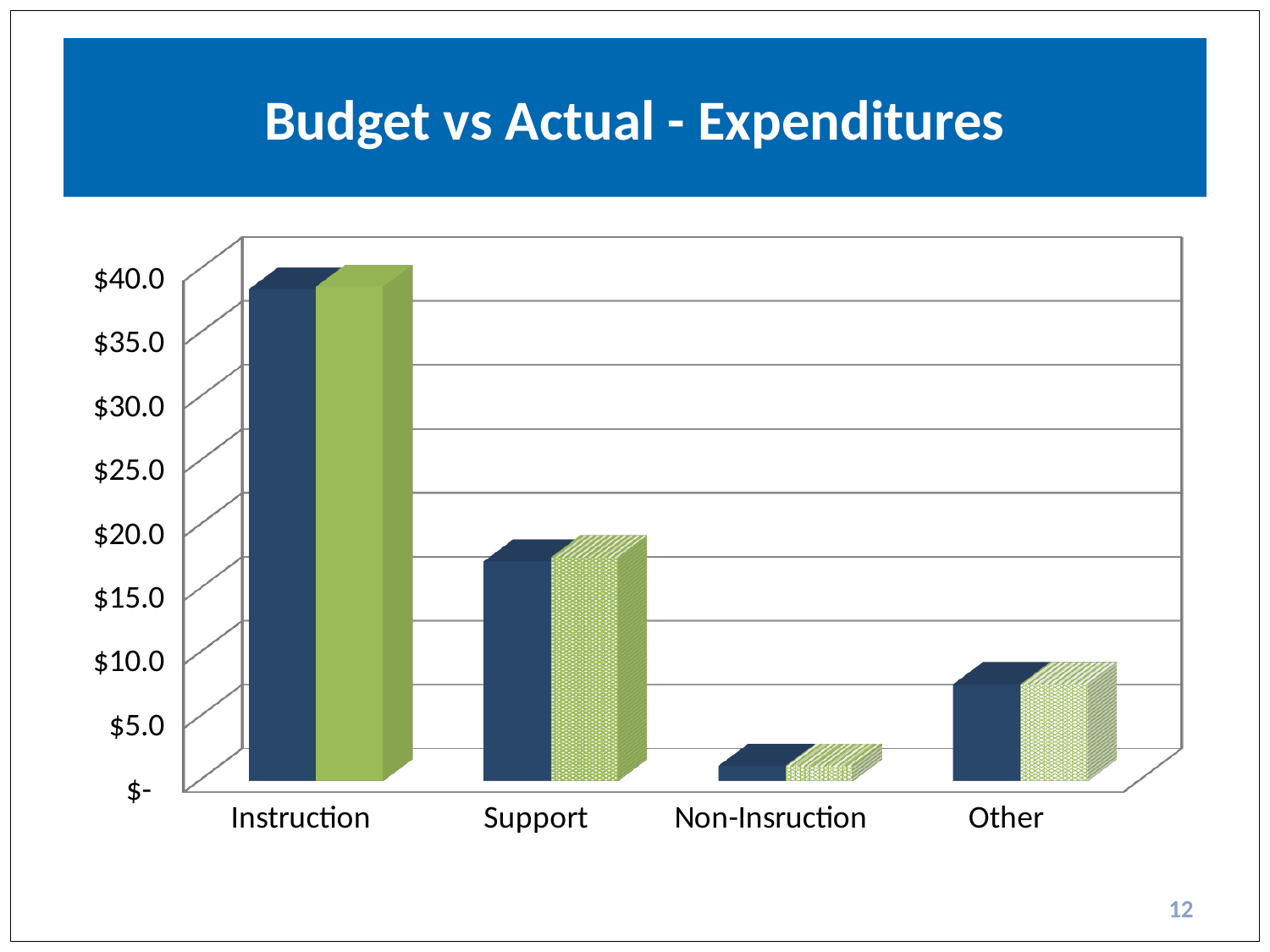
What is the highest value labelled on the vertical axis? $40.0 What kind of chart is shown on the slide? Bar chart Which category has larger bars, Support or Other? Support How many categories are shown on the x axis? 4 Is the value of the blue bar for Support greater or less than $20.0? less Is the value of the blue bar for Other greater or less than $10.0? less Is the value of the blue bar for Non-Insruction greater or less than $5.0? less What is the title of the chart? Budget vs Actual - Expenditures Which category has the lowest expenditure bars? Non-Insruction How many bars are plotted for each category? 2 Which category has the highest expenditure bars? Instruction